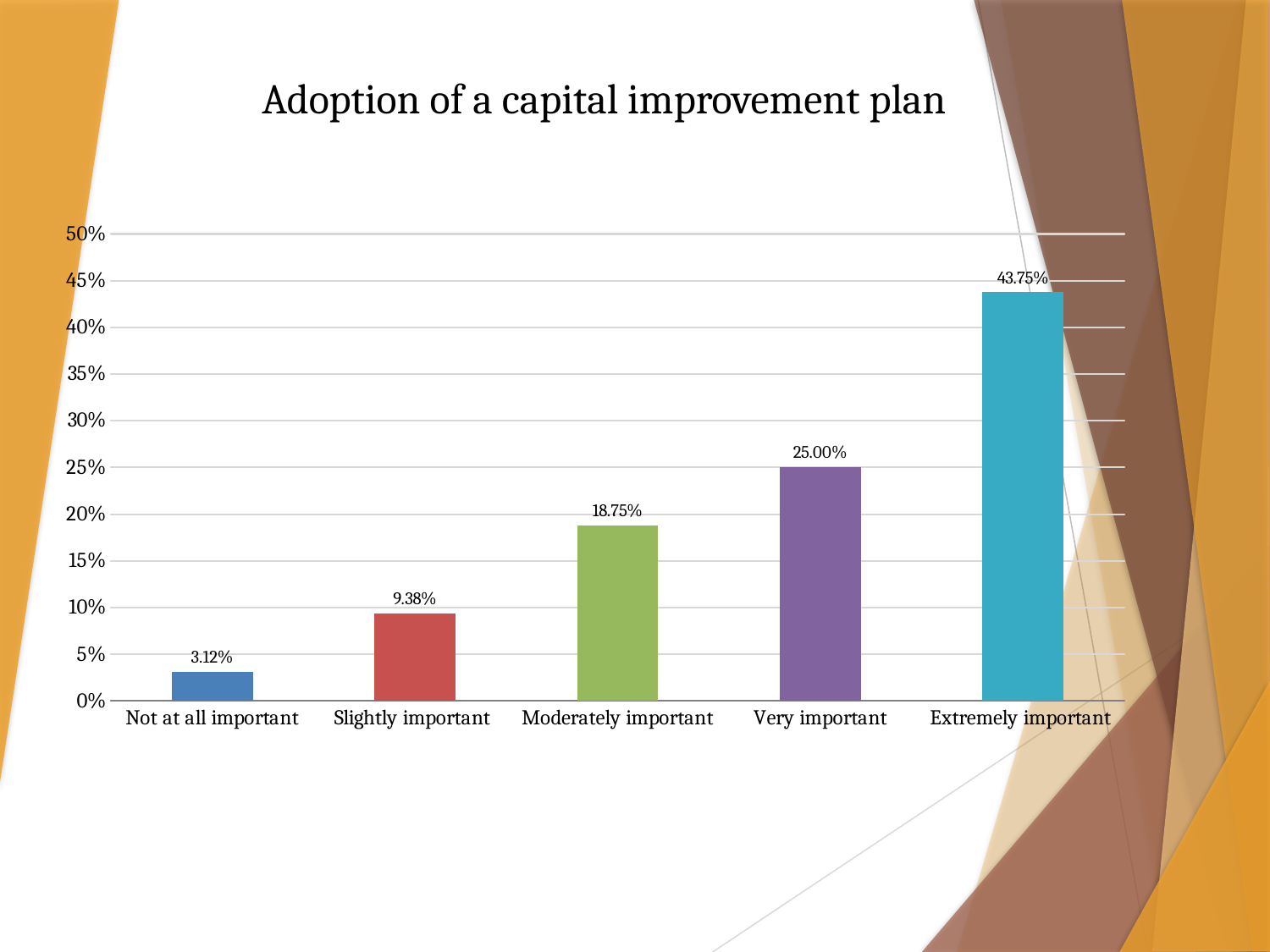
Which category has the highest value? Extremely important What is the difference between the values for Extremely important and Very important? 18.75% What is the value for Slightly important? 9.38% What is the value for Not at all important? 3.12% What kind of chart is shown on the slide? Bar chart What is the value for Extremely important? 43.75% Which is larger, the value for Moderately important or the value for Slightly important? Moderately important Do the values rise or fall from left to right along the x axis? Rise What is the value for Very important? 25.00% What is the value for Moderately important? 18.75% Which category has the lowest value? Not at all important How many categories are shown on the x axis? 5